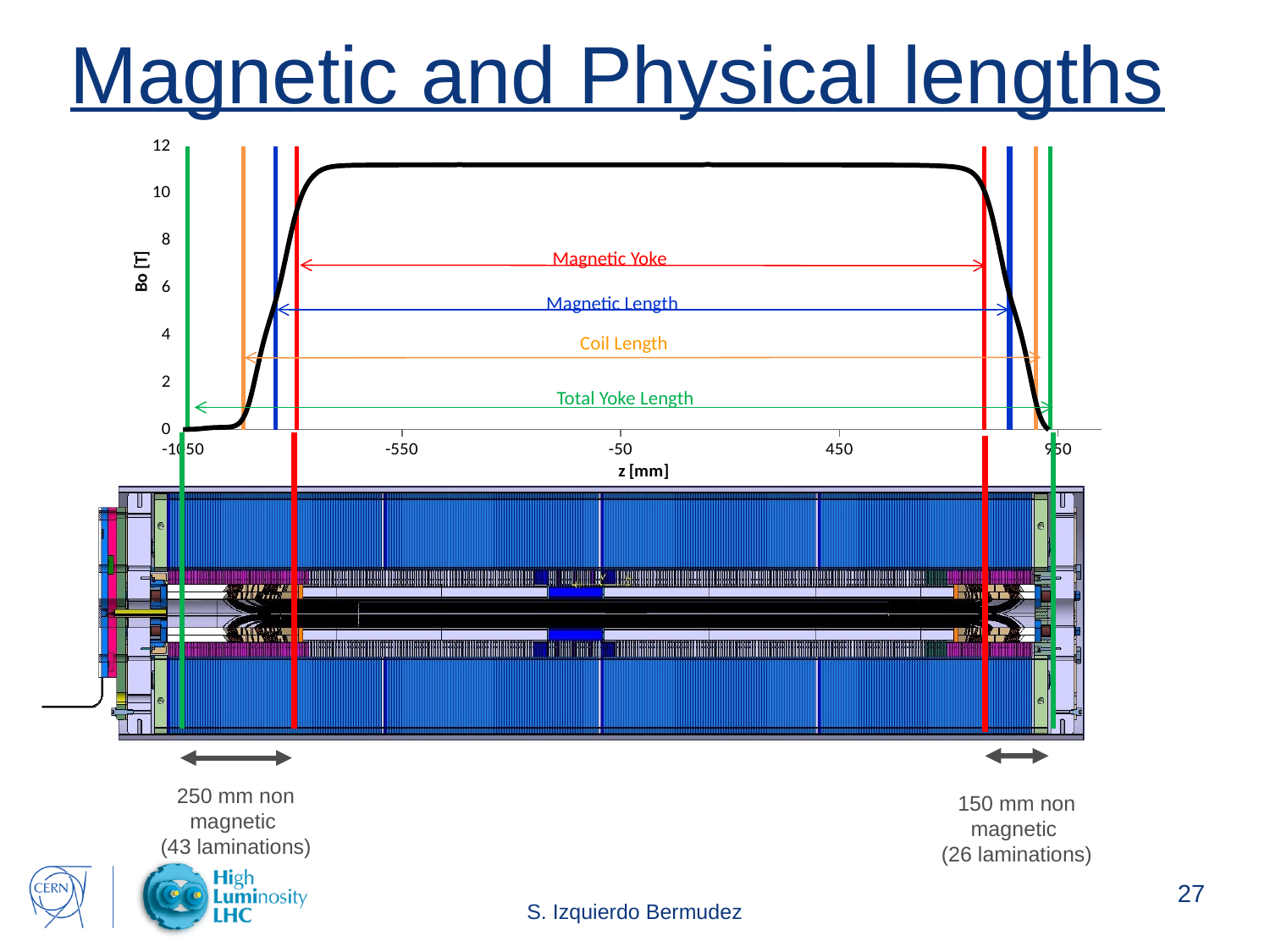
What colour is the arrow labelled Magnetic Yoke on the chart? red Is the plateau value of Bo in the centre of the magnet (around z = -50 mm) greater or less than 10 T? greater Is the plateau value of Bo in the centre of the magnet (around z = -50 mm) greater or less than 12 T? less What kind of chart is shown on the slide? line chart Which of the annotated lengths on the chart is the longest? Total Yoke Length Which is longer according to the arrows on the chart, the Coil Length or the Magnetic Length? Coil Length Does Bo rise or fall as z goes from 450 mm to 950 mm? falls What is the label of the vertical axis of the chart? Bo [T] Which is longer according to the arrows on the chart, the Magnetic Yoke or the Magnetic Length? Magnetic Length Is the value of Bo at z = -1050 mm greater or less than 2 T? less Which of the annotated lengths on the chart is the shortest? Magnetic Yoke Does Bo rise or fall as z goes from -1050 mm to -550 mm? rises